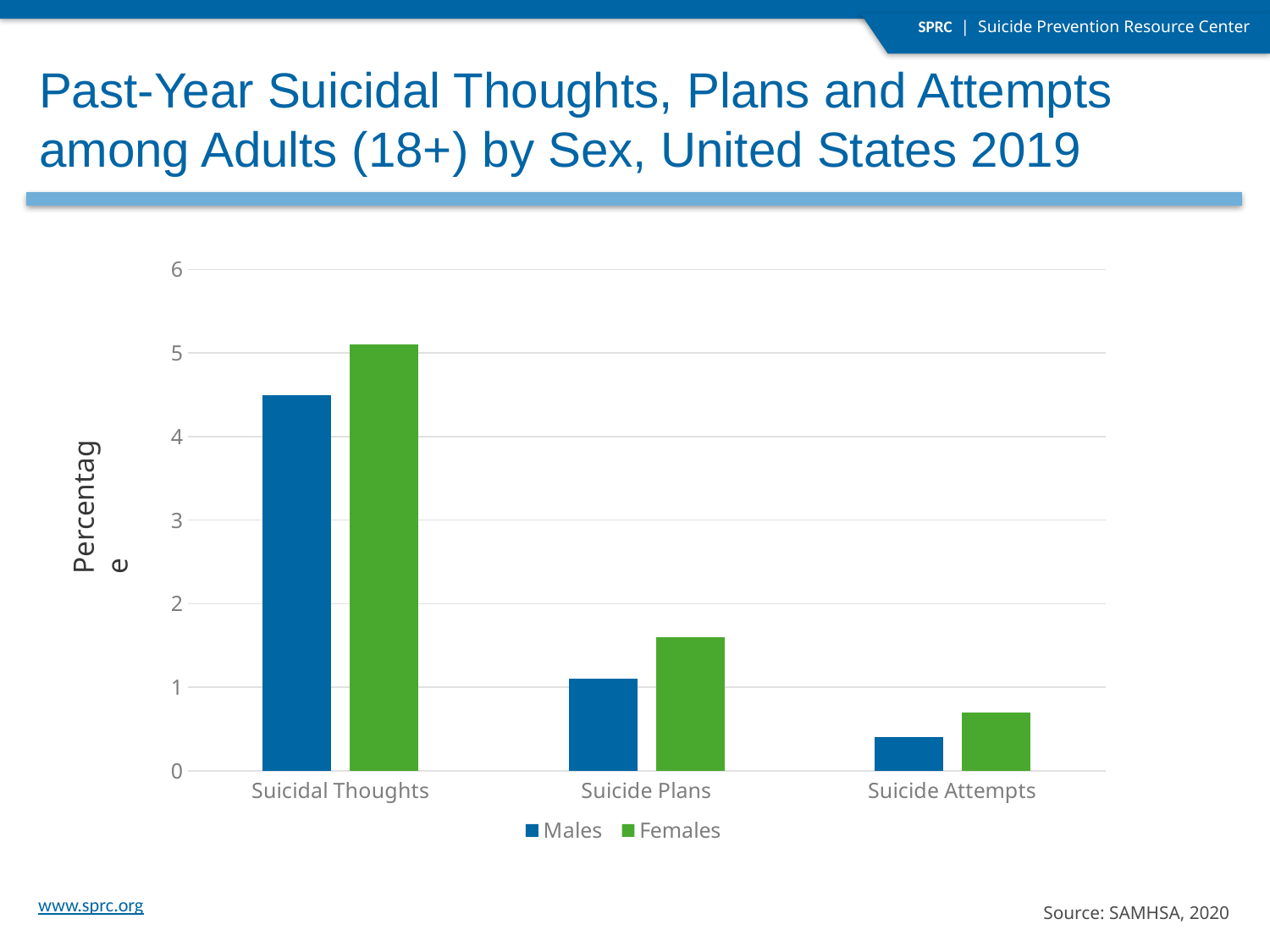
Is the value for Males in Suicide Attempts greater or less than 1? less Is the value for Males in Suicidal Thoughts greater or less than 4? greater Which category has the highest value for Females? Suicidal Thoughts How many categories are shown on the x axis? 3 Which series are listed in the legend? Males, Females Is the value for Females in Suicidal Thoughts greater or less than 5? greater Which category has the lowest value for Males? Suicide Attempts What kind of chart is shown on the slide? bar chart What is the label of the vertical axis? Percentage For Suicide Plans, which is larger, the value for Males or for Females? Females How many series does the legend list? 2 For Suicidal Thoughts, which is larger, the value for Males or for Females? Females